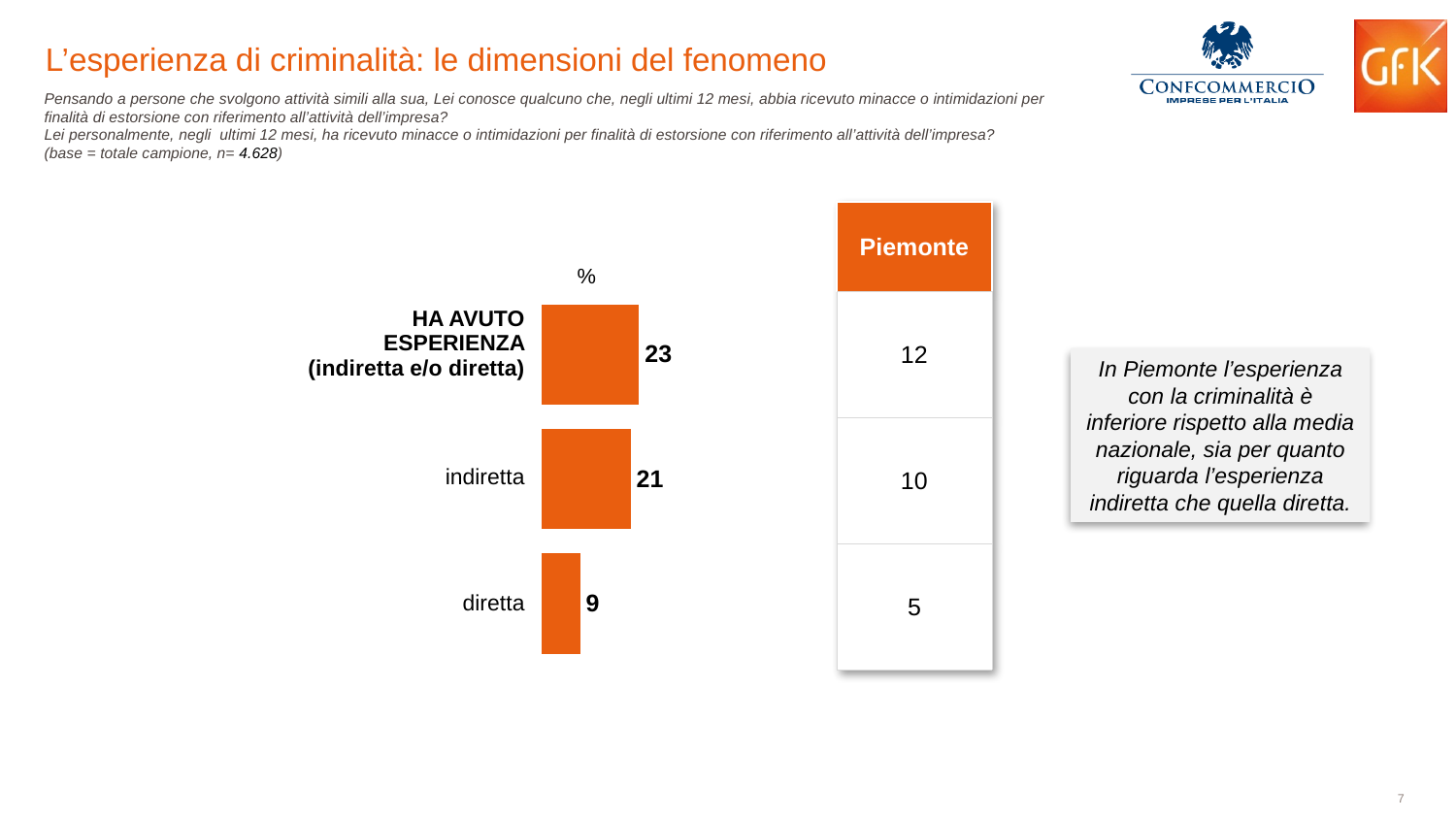
What is the value for 'indiretta' in the bar chart? 21 Which is larger in the bar chart, the value for 'indiretta' or the value for 'diretta'? indiretta What is the difference between the values for 'HA AVUTO ESPERIENZA (indiretta e/o diretta)' and 'indiretta' in the bar chart? 2 What is the value for 'diretta' in the bar chart? 9 What is the difference between the values for 'indiretta' and 'diretta' in the bar chart? 12 What kind of chart is shown on the slide? bar chart Which category has the highest value in the bar chart? HA AVUTO ESPERIENZA (indiretta e/o diretta) In the Piemonte column next to the chart, what is the value for 'diretta'? 5 What unit label is shown above the bars in the chart? % Which category has the lowest value in the bar chart? diretta What is the value for 'HA AVUTO ESPERIENZA (indiretta e/o diretta)' in the bar chart? 23 How many categories are shown in the bar chart? 3